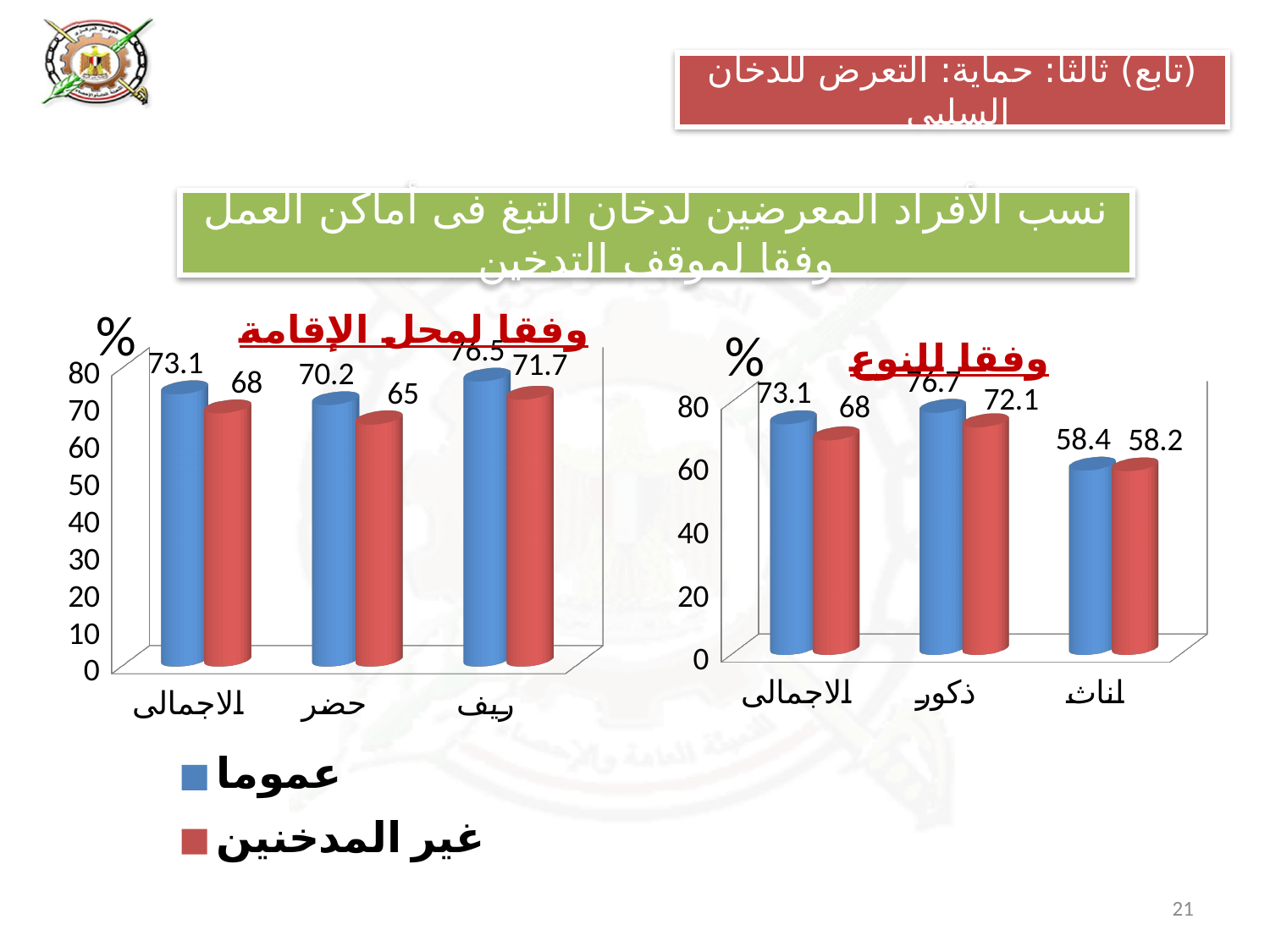
In the left chart (وفقا لمحل الإقامة), what is the value of عموما for ريف? 76.5 In the left chart (وفقا لمحل الإقامة), what is the difference between عموما and غير المدخنين for الاجمالى? 5.1 What type of chart is the left chart (وفقا لمحل الإقامة)? Bar chart In the right chart (وفقا للنوع), which category has the lowest value for غير المدخنين? اناث In the left chart (وفقا لمحل الإقامة), which category has the highest value for عموما? ريف In the right chart (وفقا للنوع), what is the value of عموما for ذكور? 76.7 In the left chart (وفقا لمحل الإقامة), what is the value of غير المدخنين for حضر? 65 How many categories are shown on the x axis of the right chart (وفقا للنوع)? 3 In the right chart (وفقا للنوع), what is the difference between the عموما values for ذكور and اناث? 18.3 In the left chart (وفقا لمحل الإقامة), which is larger: عموما for حضر or غير المدخنين for ريف? غير المدخنين for ريف In the right chart (وفقا للنوع), what is the value of غير المدخنين for اناث? 58.2 How many series does the legend list? 2